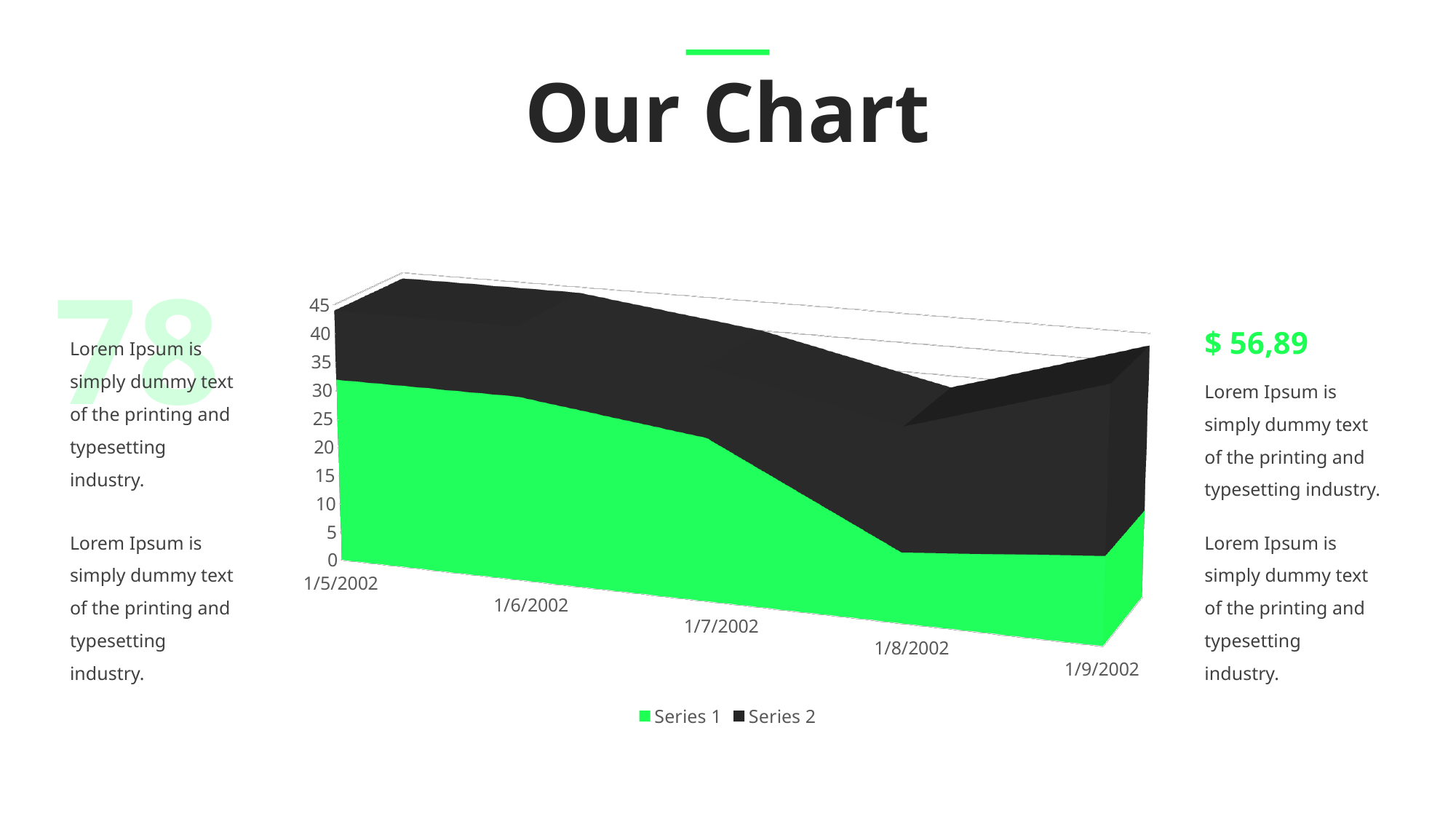
Which series is shown in green in the chart? Series 1 Does the value for Series 1 rise or fall from 1/5/2002 to 1/8/2002? fall What is the title of the slide containing the chart? Our Chart Is the stacked total on 1/5/2002 greater or less than 40? greater Is the value for Series 1 on 1/5/2002 greater or less than 20? greater What kind of chart is shown on the slide? area chart On which date is the value for Series 1 lowest? 1/8/2002 How many dates are shown on the x axis of the chart? 5 How many series does the chart legend list? 2 Which is larger for Series 1: the value on 1/6/2002 or the value on 1/8/2002? 1/6/2002